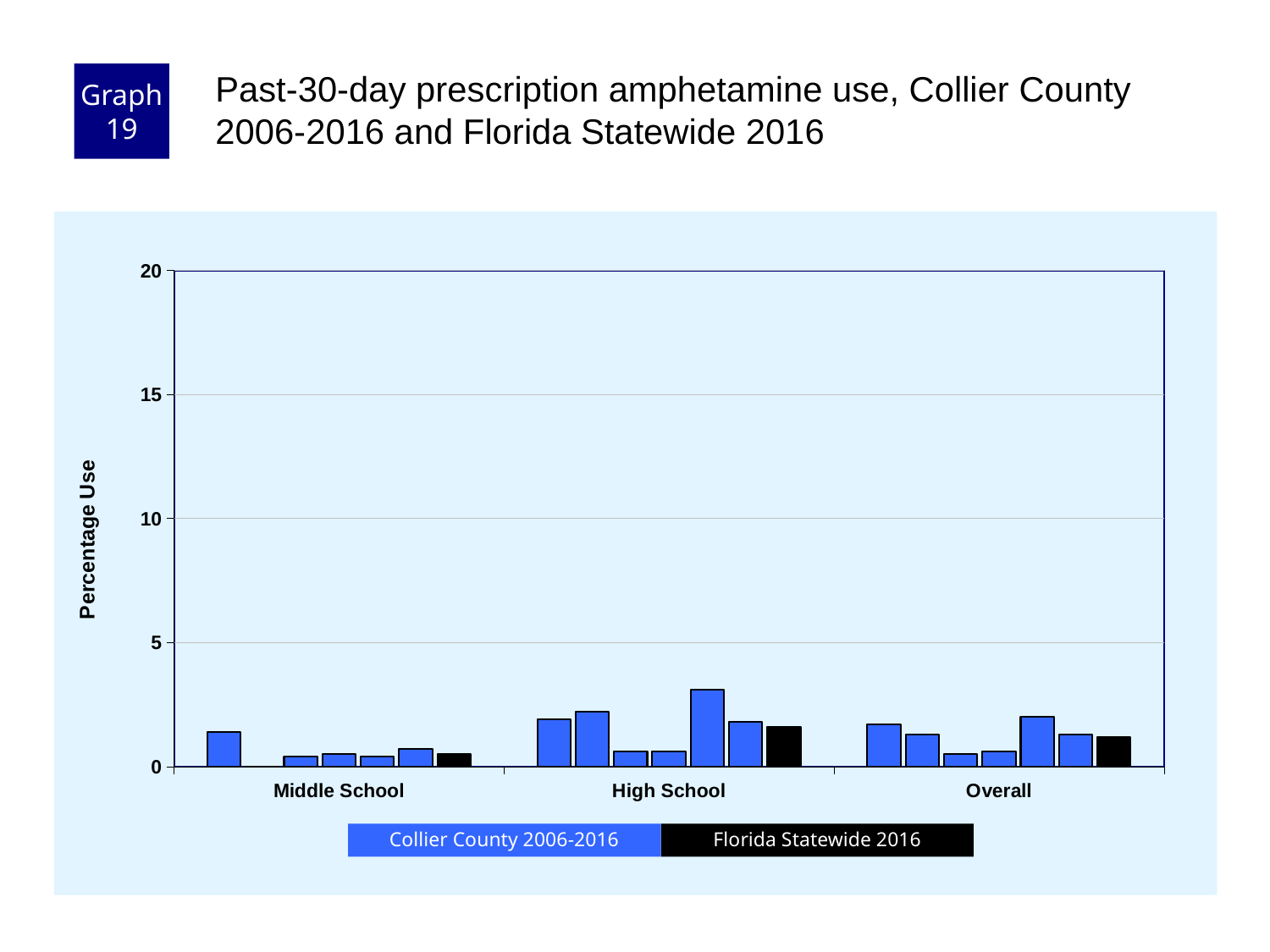
Which series is shown in black in the legend? Florida Statewide 2016 How many series does the legend list? 2 How many categories are shown along the x axis? 3 What is the label of the y axis? Percentage Use Is the Florida Statewide 2016 bar larger for Overall or for Middle School? Overall Is the Florida Statewide 2016 bar larger for High School or for Middle School? High School Is the tallest bar in the High School category greater or less than 5? less Is the value for Florida Statewide 2016 in the Middle School category greater or less than 5? less Which category has the tallest Florida Statewide 2016 bar? High School Is the value for Florida Statewide 2016 in the High School category greater or less than 5? less What kind of chart is shown on the slide? Bar chart Which category contains the tallest bar on the chart? High School